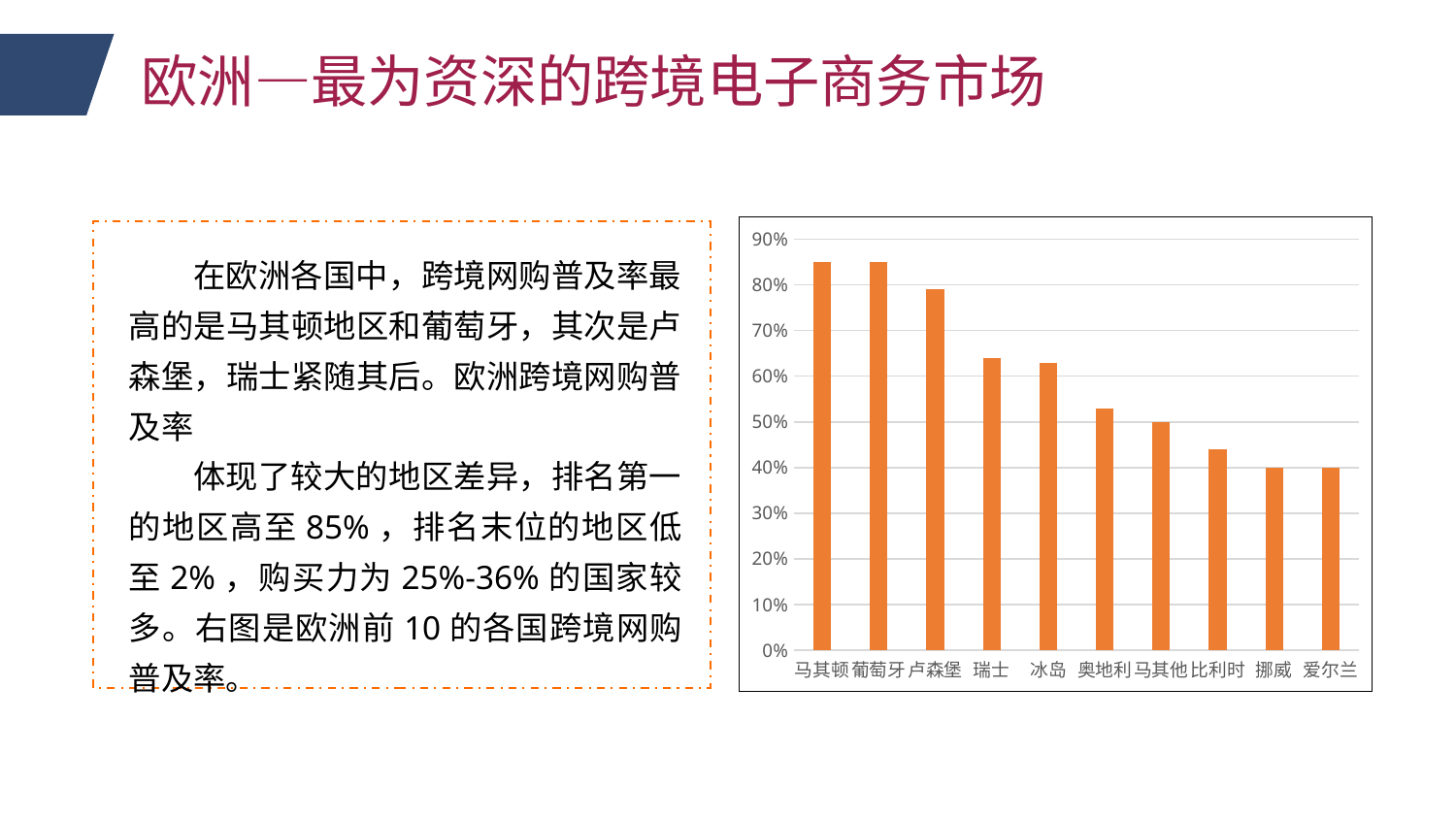
What kind of chart is shown on the slide? bar chart Which has the larger value, 卢森堡 or 瑞士? 卢森堡 Is the value for 卢森堡 greater or less than 70%? greater Is the value for 奥地利 greater or less than 60%? less Is the value for 葡萄牙 greater or less than 80%? greater What is the highest value shown on the chart's y axis? 90% Which has the larger value, 奥地利 or 比利时? 奥地利 How many countries or regions are shown on the x axis of the chart? 10 Do the bar values rise or fall from left to right across the chart? fall